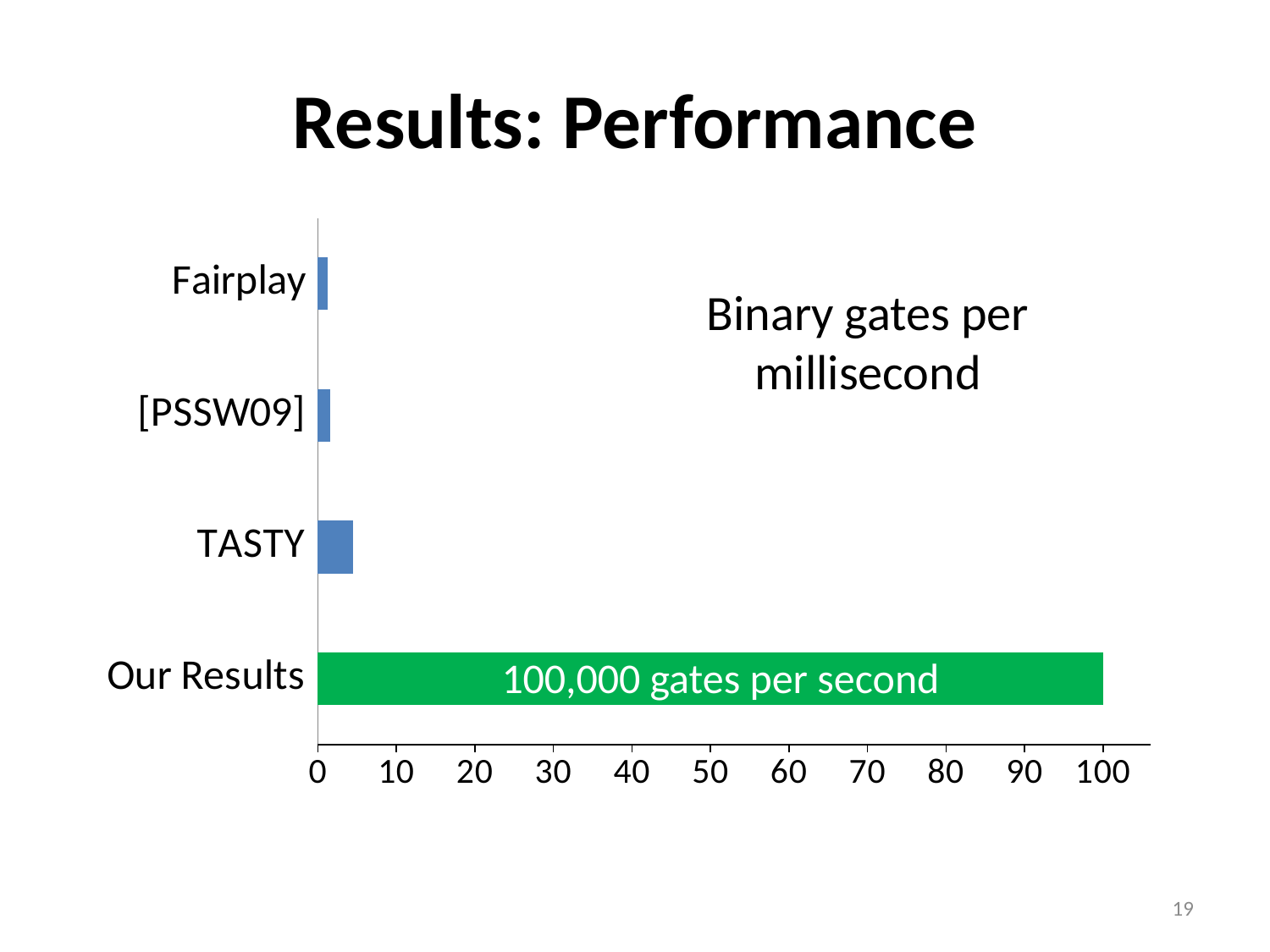
What kind of chart is shown on the slide? bar chart What value does the bar for Our Results reach on the axis? 100 Is the value for Our Results greater or less than 90? greater What unit does the chart say the values are measured in? Binary gates per millisecond Which category has the highest value in the chart? Our Results Is the value for TASTY greater or less than 10? less What text is printed on the bar for Our Results? 100,000 gates per second How many categories are plotted in the chart? 4 Which is larger, the value for Our Results or the value for [PSSW09]? Our Results Which is larger, the value for TASTY or the value for Fairplay? TASTY Is the value for Fairplay greater or less than 10? less